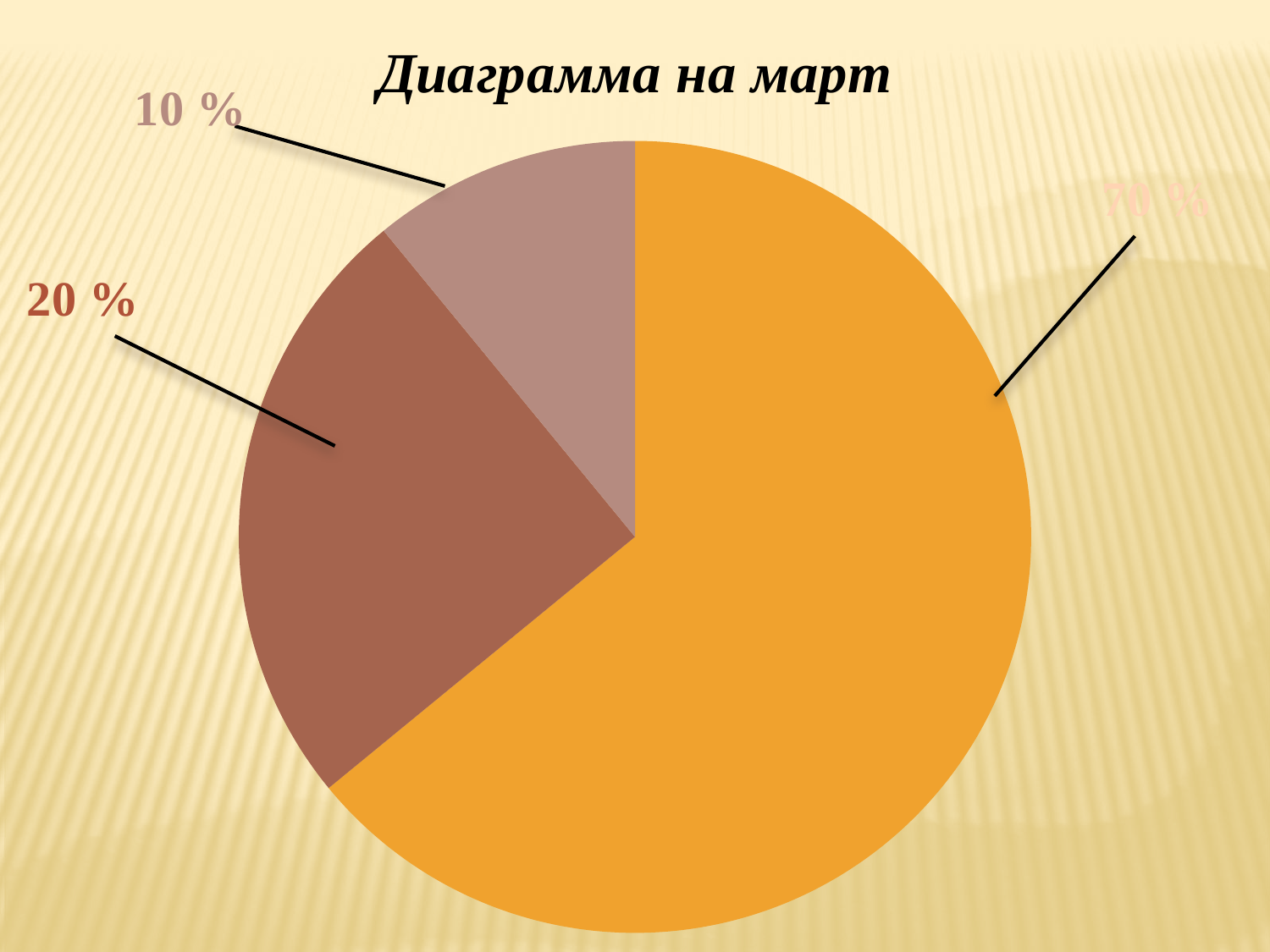
How many slices does the pie chart have? 3 What is the difference between the 20 % slice and the 10 % slice? 10 % Which slice is the smallest in the pie chart? the light mauve-brown slice (10 %) What share of the pie does the light mauve-brown slice represent? 10 % What share of the pie does the dark brown slice represent? 20 % Which is larger, the dark brown slice or the light mauve-brown slice? the dark brown slice What kind of chart is shown on the slide? pie chart What is the difference between the largest slice and the smallest slice? 60 % What is the title of the chart? Диаграмма на март Which slice is the largest in the pie chart? the orange slice (70 %) What colour is the slice labelled 70 %? orange What share of the pie does the orange slice represent? 70 %